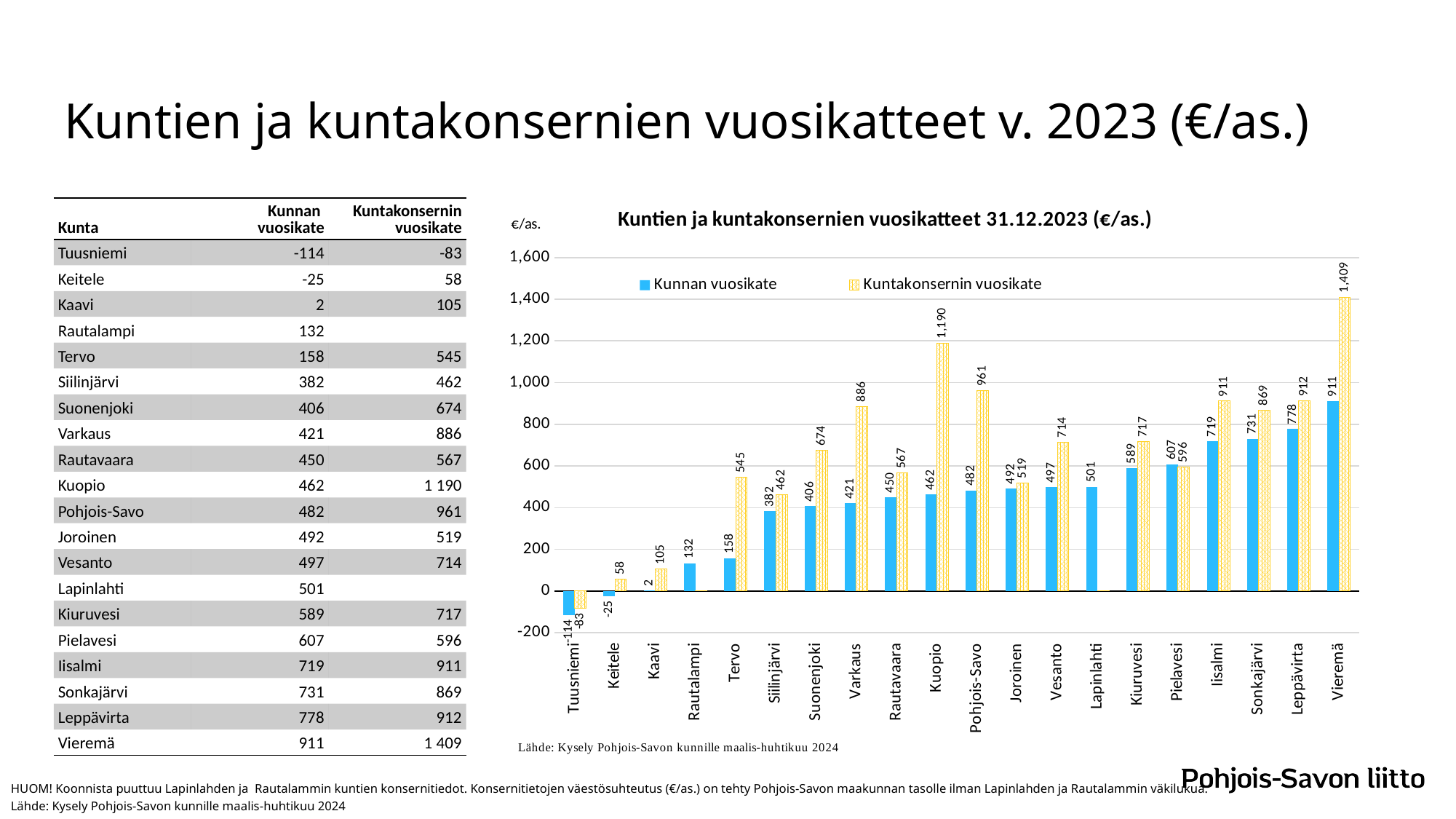
How many municipalities/categories are shown on the x axis of the chart? 20 What is the Kunnan vuosikate value for Varkaus? 421 What is the title of the chart? Kuntien ja kuntakonsernien vuosikatteet 31.12.2023 (€/as.) Which municipality has the highest Kuntakonsernin vuosikate? Vieremä Which is larger for Pielavesi, the Kunnan vuosikate or the Kuntakonsernin vuosikate? Kunnan vuosikate What kind of chart is shown on the slide? Bar chart What is the Kuntakonsernin vuosikate value for Tervo? 545 Is the Kuntakonsernin vuosikate for Pohjois-Savo greater or less than 800? greater Which municipality has the lowest Kunnan vuosikate? Tuusniemi What is the Kuntakonsernin vuosikate value for Kuopio? 1,190 How many series does the chart legend list? 2 What is the difference between the Kuntakonsernin vuosikate and the Kunnan vuosikate for Varkaus? 465